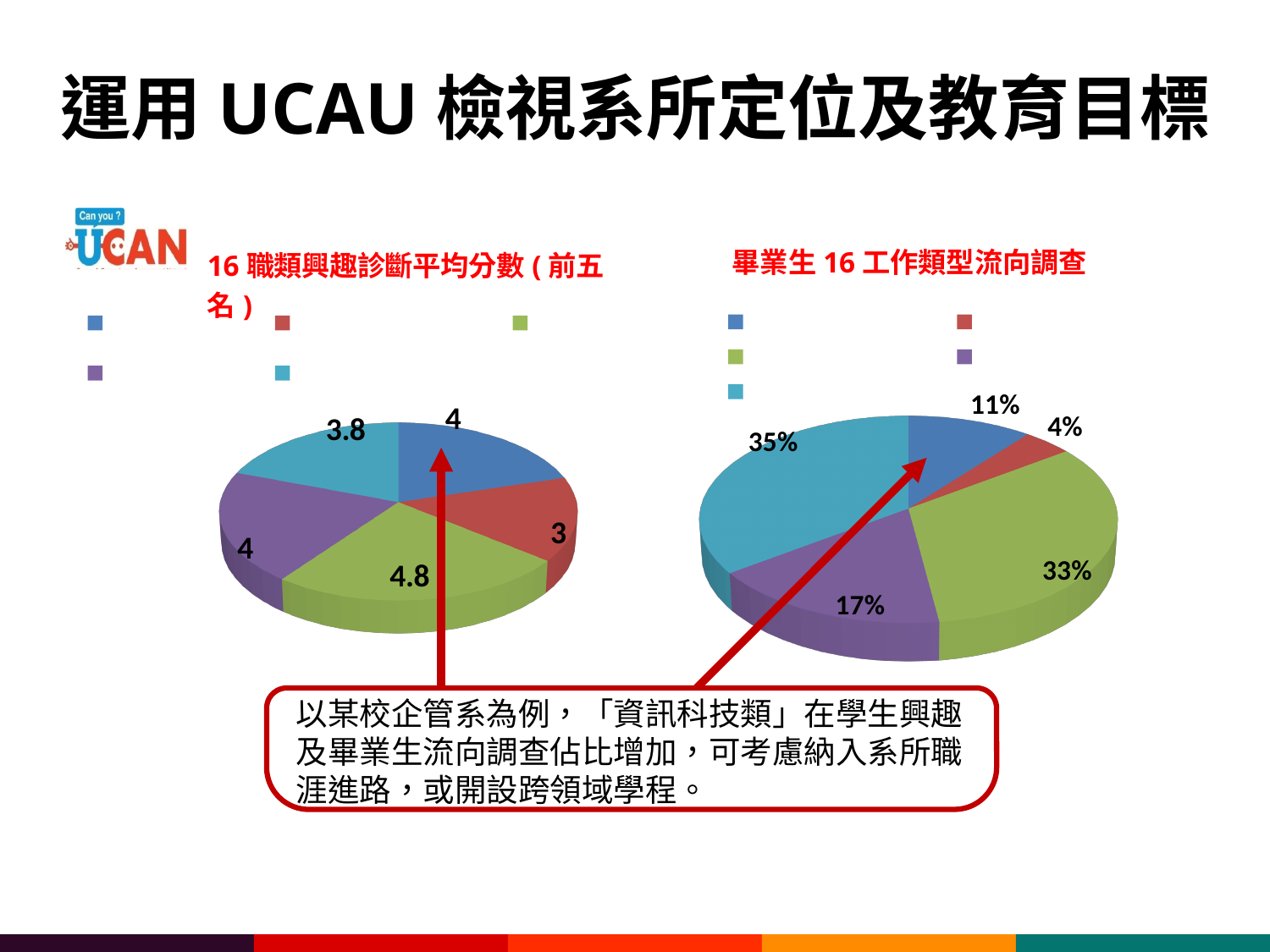
How many slices does the left chart (16 職類興趣診斷平均分數) have? 5 In the right chart (畢業生16工作類型流向調查), what is the largest share shown on a slice? 35% What is the title of the right chart? 畢業生16工作類型流向調查 In the right chart (畢業生16工作類型流向調查), how much larger is the largest slice than the smallest slice? 31% What kind of chart is the left chart titled 16 職類興趣診斷平均分數(前五名)? pie chart In the left chart (16 職類興趣診斷平均分數), what is the largest value shown on a slice? 4.8 How many slices does the right chart (畢業生16工作類型流向調查) have? 5 In the right chart (畢業生16工作類型流向調查), which is larger, the green slice or the purple slice? the green slice What kind of chart is the right chart titled 畢業生16工作類型流向調查? pie chart In the right chart (畢業生16工作類型流向調查), what is the smallest share shown on a slice? 4% In the left chart (16 職類興趣診斷平均分數), what is the difference between the largest and smallest slice values? 1.8 In the left chart (16 職類興趣診斷平均分數), what is the smallest value shown on a slice? 3